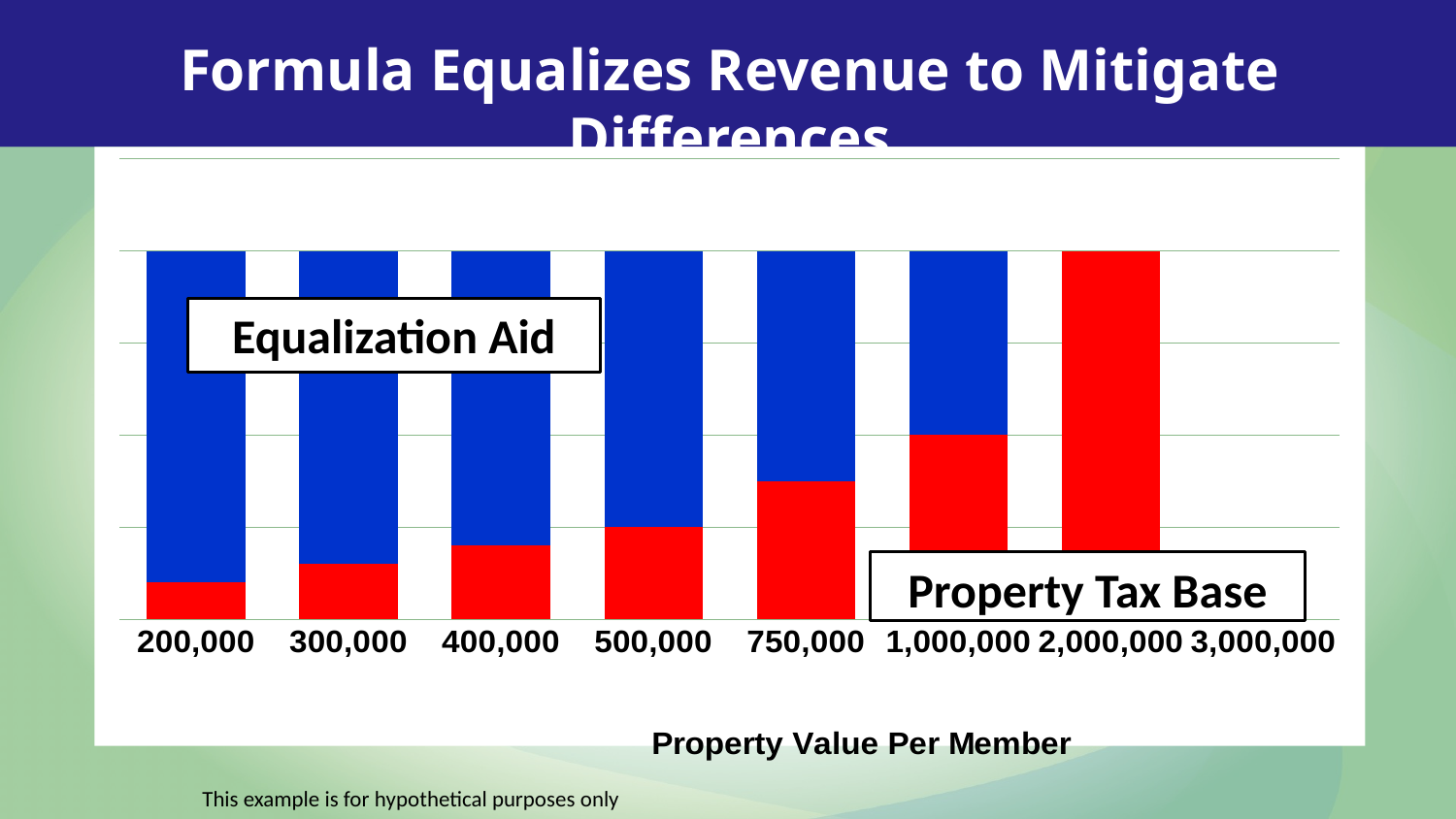
Which category has the smallest Property Tax Base (red) portion? 200,000 What is the title of the x axis of the chart? Property Value Per Member Which has the larger Equalization Aid (blue) portion, 300,000 or 1,000,000? 300,000 Does the Property Tax Base (red) portion rise or fall as property value per member increases along the x axis? Rise Which category has the largest Equalization Aid (blue) portion? 200,000 How many categories are labeled along the x axis of the chart? 8 Which has the larger Property Tax Base (red) portion, 750,000 or 1,000,000? 1,000,000 What kind of chart is shown on the slide? Stacked bar chart Which visible bar has the largest Property Tax Base (red) portion? 2,000,000 Does the Equalization Aid (blue) portion rise or fall as property value per member increases along the x axis? Fall Which has the larger Property Tax Base (red) portion, 200,000 or 500,000? 500,000 Which colour represents Property Tax Base in the chart? Red